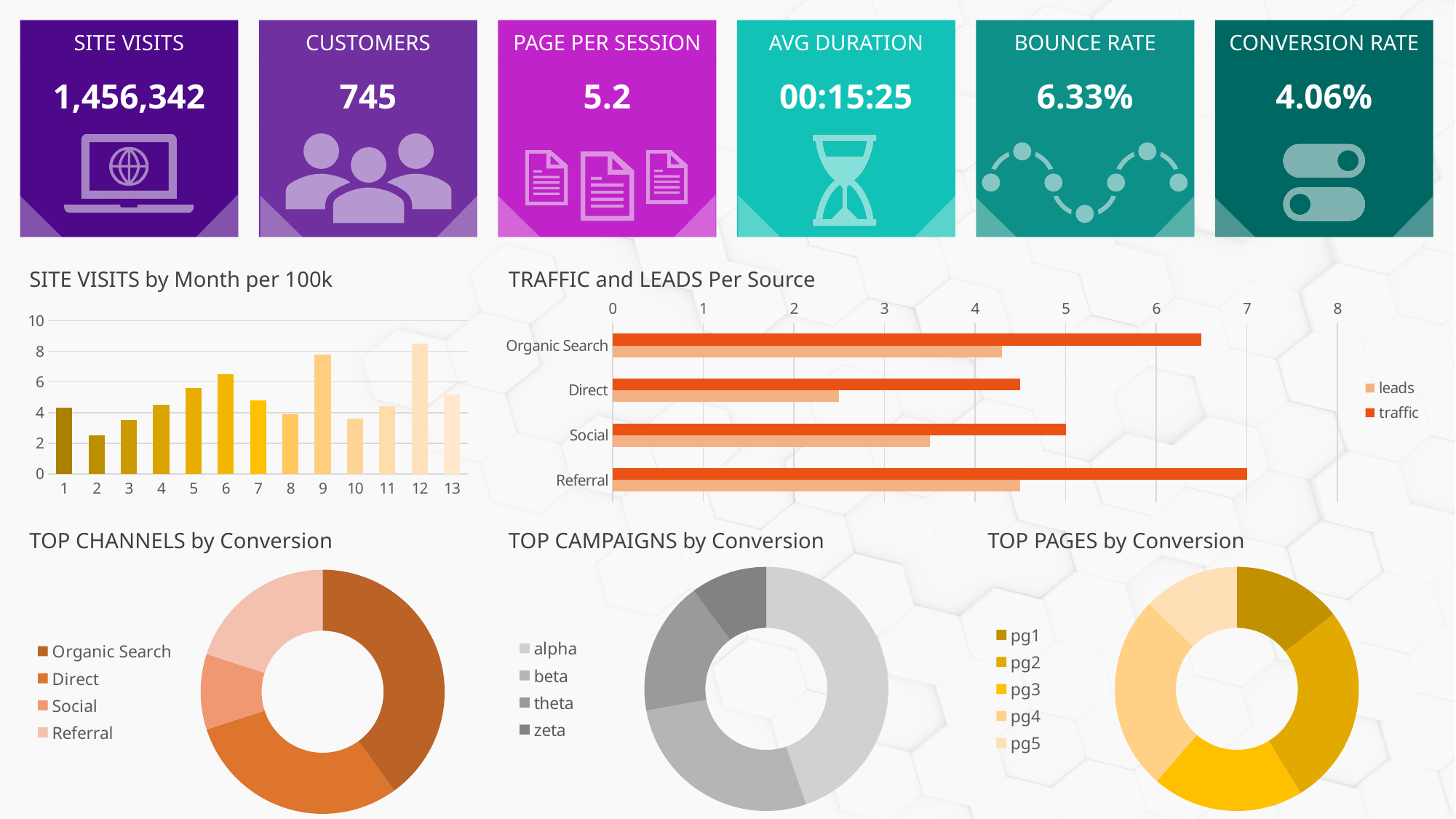
In the TOP PAGES by Conversion chart, how many pages does the legend list? 5 In the TRAFFIC and LEADS Per Source chart, how many series does the legend list? 2 What kind of chart is TRAFFIC and LEADS Per Source? Bar chart In the SITE VISITS by Month per 100k chart, how many months are plotted? 13 In the TRAFFIC and LEADS Per Source chart, is the traffic value for Organic Search greater or less than 6? greater In the SITE VISITS by Month per 100k chart, is the value for month 6 larger than the value for month 7? Yes, month 6 In the SITE VISITS by Month per 100k chart, which month has the lowest bar? 2 In the SITE VISITS by Month per 100k chart, which month has the highest bar? 12 In the TRAFFIC and LEADS Per Source chart, which source has the highest traffic value? Referral In the SITE VISITS by Month per 100k chart, is the value for month 9 greater or less than 6? greater In the TOP CAMPAIGNS by Conversion chart, which campaign has the largest slice? alpha In the TRAFFIC and LEADS Per Source chart, which source has the lowest leads value? Direct